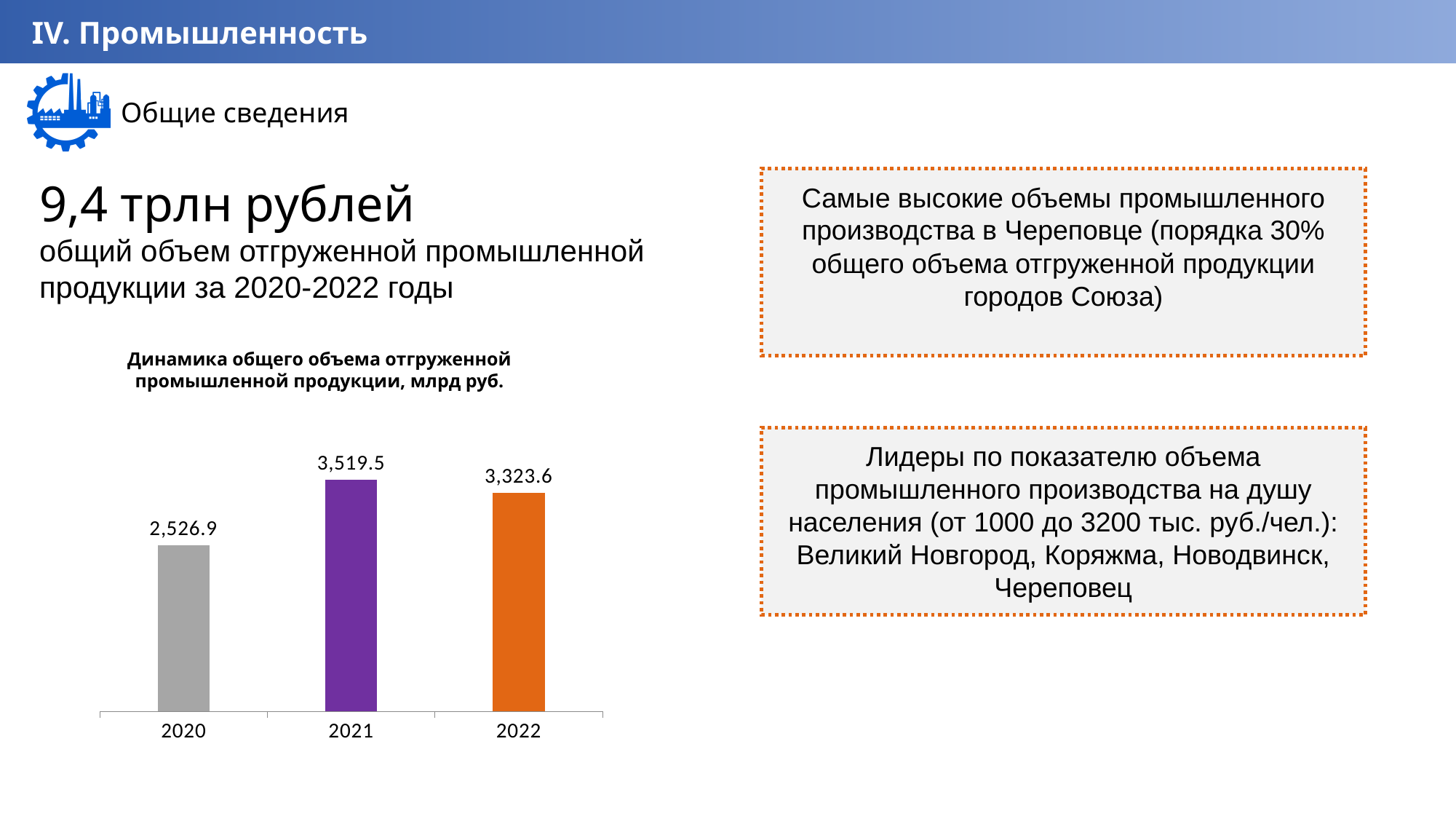
What is the value for 2020 in the chart? 2,526.9 What is the value for 2021 in the chart? 3,519.5 What unit is given in the chart title? млрд руб. What is the difference between the values for 2021 and 2022? 195.9 What kind of chart is shown on the slide? Bar chart Which year has the lowest value in the chart? 2020 Which year has the highest value in the chart? 2021 Which is larger, the value for 2022 or the value for 2020? 2022 Do the values rise or fall from 2021 to 2022? Fall How many years are shown in the chart? 3 What is the value for 2022 in the chart? 3,323.6 What is the difference between the values for 2021 and 2020? 992.6